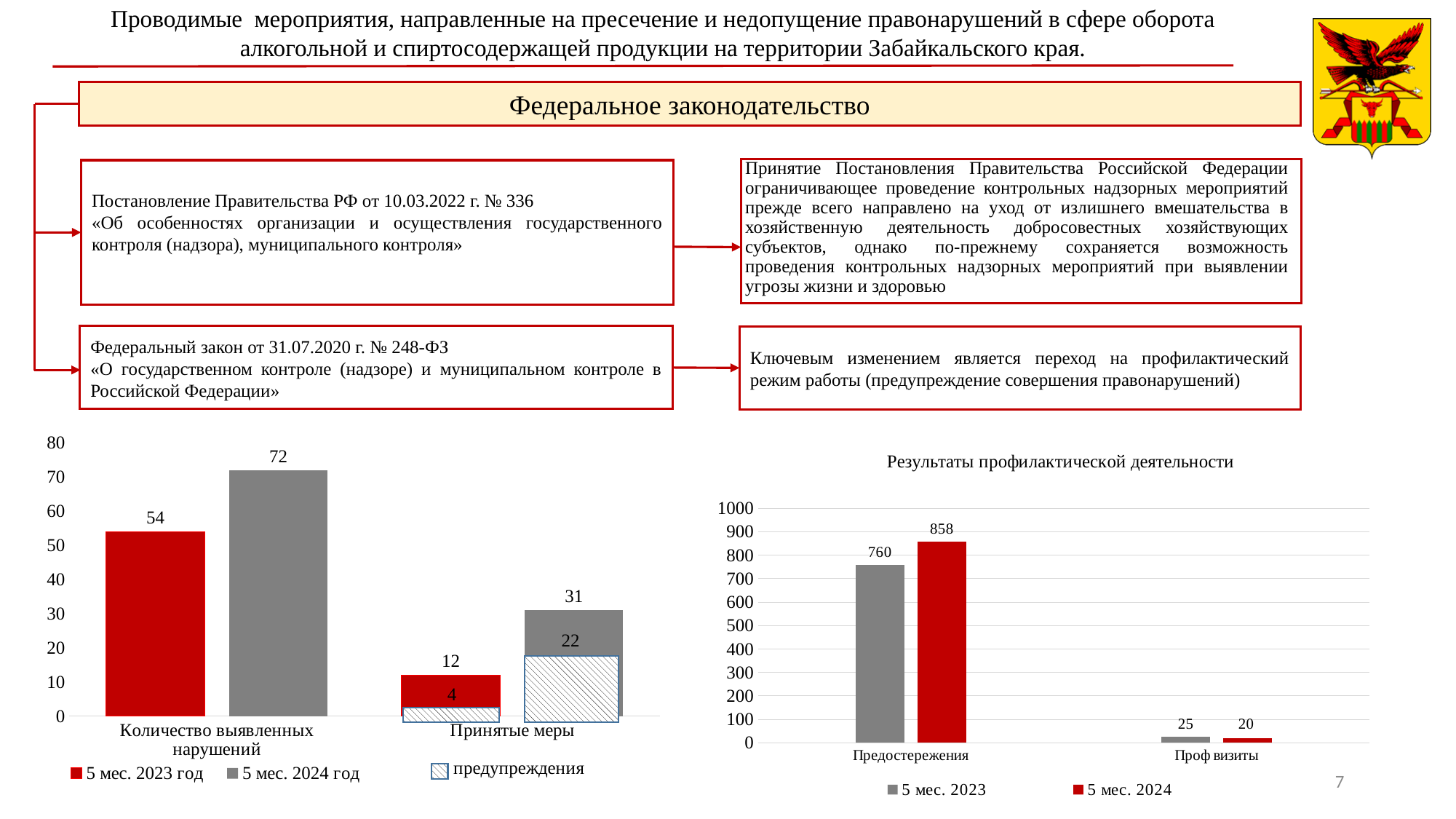
In the chart 'Результаты профилактической деятельности', what is the difference between the '5 мес. 2024' and '5 мес. 2023' values for 'Предостережения'? 98 In the chart 'Результаты профилактической деятельности', how many categories are shown on the x axis? 2 What kind of chart is the chart titled 'Результаты профилактической деятельности'? bar chart In the chart 'Результаты профилактической деятельности', what is the value for '5 мес. 2024' in the category 'Предостережения'? 858 In the left chart, what is the value for '5 мес. 2023 год' in the category 'Количество выявленных нарушений'? 54 In the left chart, what is the value for '5 мес. 2024 год' in the category 'Принятые меры'? 31 In the left chart, what is the difference between the '5 мес. 2024 год' and '5 мес. 2023 год' values for 'Количество выявленных нарушений'? 18 In the left chart, which series has the larger value for 'Принятые меры': '5 мес. 2023 год' or '5 мес. 2024 год'? 5 мес. 2024 год In the chart 'Результаты профилактической деятельности', which category has the lowest value for '5 мес. 2024'? Проф визиты In the chart 'Результаты профилактической деятельности', what is the value for '5 мес. 2023' in the category 'Проф визиты'? 25 In the left chart, what is the value for '5 мес. 2024 год' in the category 'Количество выявленных нарушений'? 72